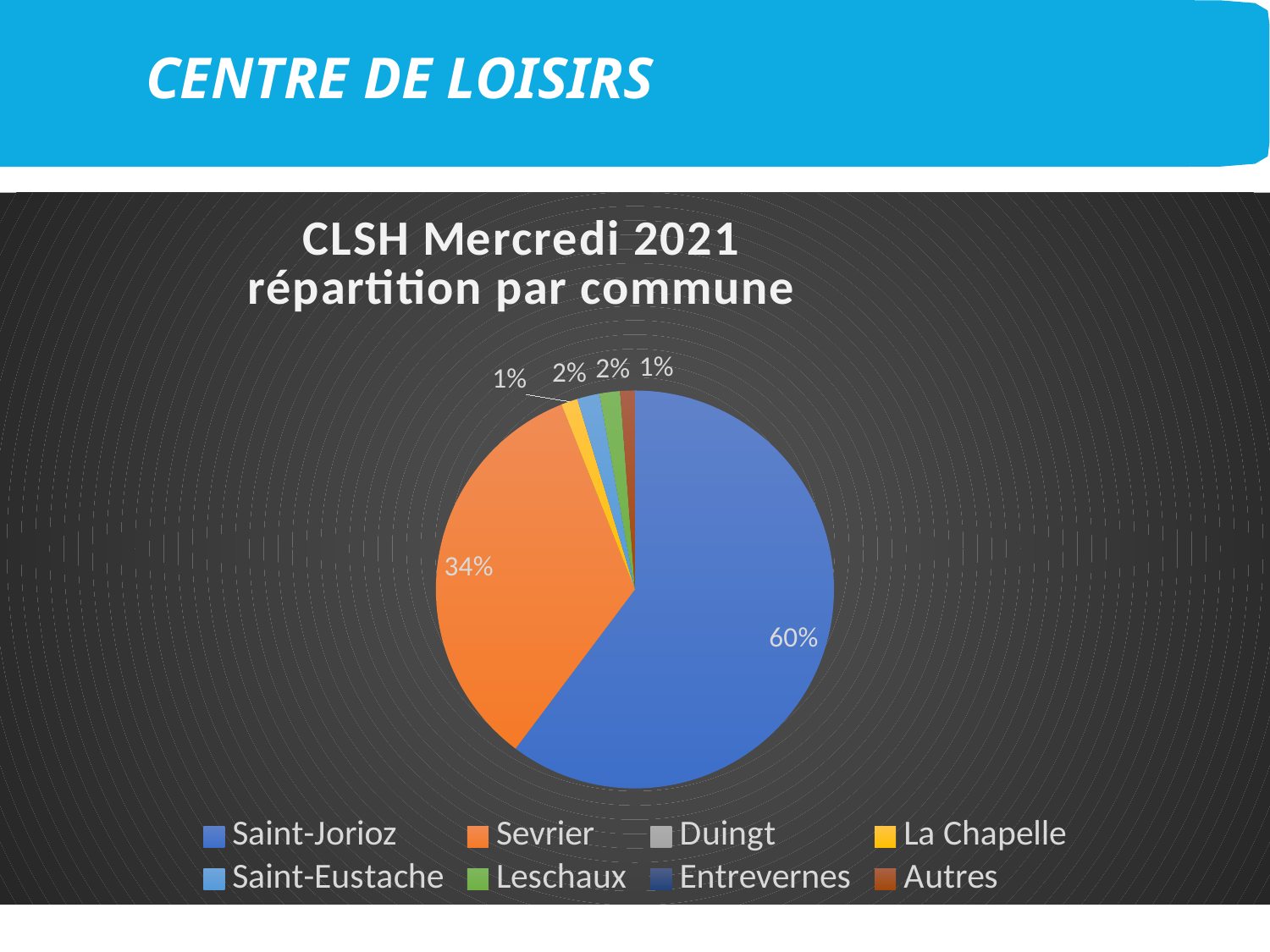
What is the difference in percentage points between the Saint-Jorioz and Sevrier slices? 26 percentage points How many communes are listed in the chart legend? 8 What share of the pie does Autres represent? 1% Which commune has the largest slice of the pie? Saint-Jorioz Which slice is larger, Sevrier or Saint-Jorioz? Saint-Jorioz What kind of chart is shown on the slide? Pie chart What share of the pie does Leschaux represent? 2% What is the combined share of Saint-Jorioz and Sevrier? 94% What share of the pie does Saint-Eustache represent? 2% What is the title of the chart? CLSH Mercredi 2021 répartition par commune